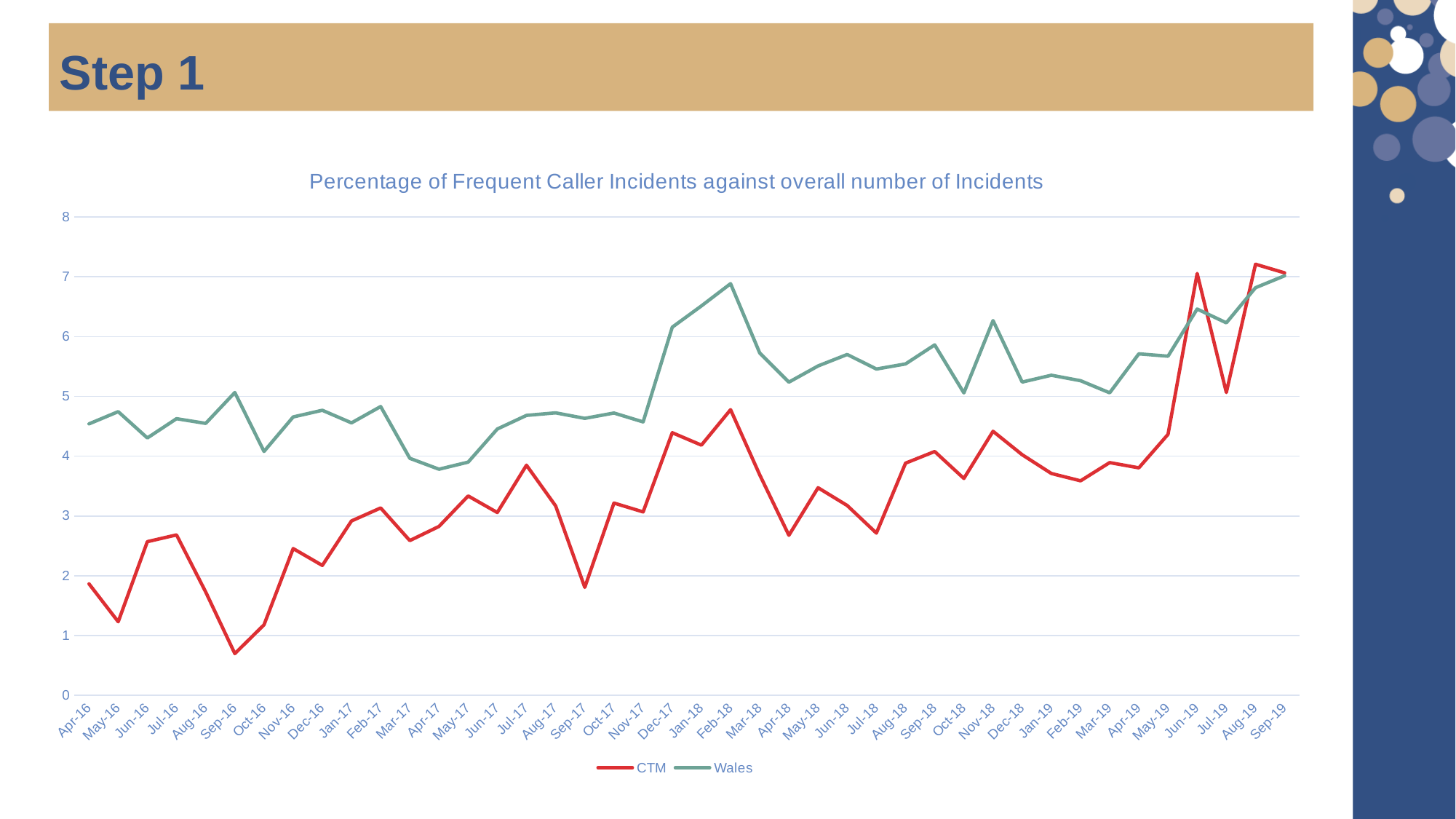
Is the CTM value for Sep-16 greater or less than 1? less In which month is the CTM value lowest? Sep-16 Overall, does the CTM line rise or fall from Apr-16 to Sep-19? Rise How many series does the legend list? 2 In Feb-18, which series has the higher value, CTM or Wales? Wales Is the Wales value for Feb-18 greater or less than 6? greater How many months are shown along the x axis? 42 Is the CTM value for Sep-17 greater or less than 2? less Which series is drawn in red? CTM What is the title of the chart? Percentage of Frequent Caller Incidents against overall number of Incidents What kind of chart is shown on the slide? Line chart